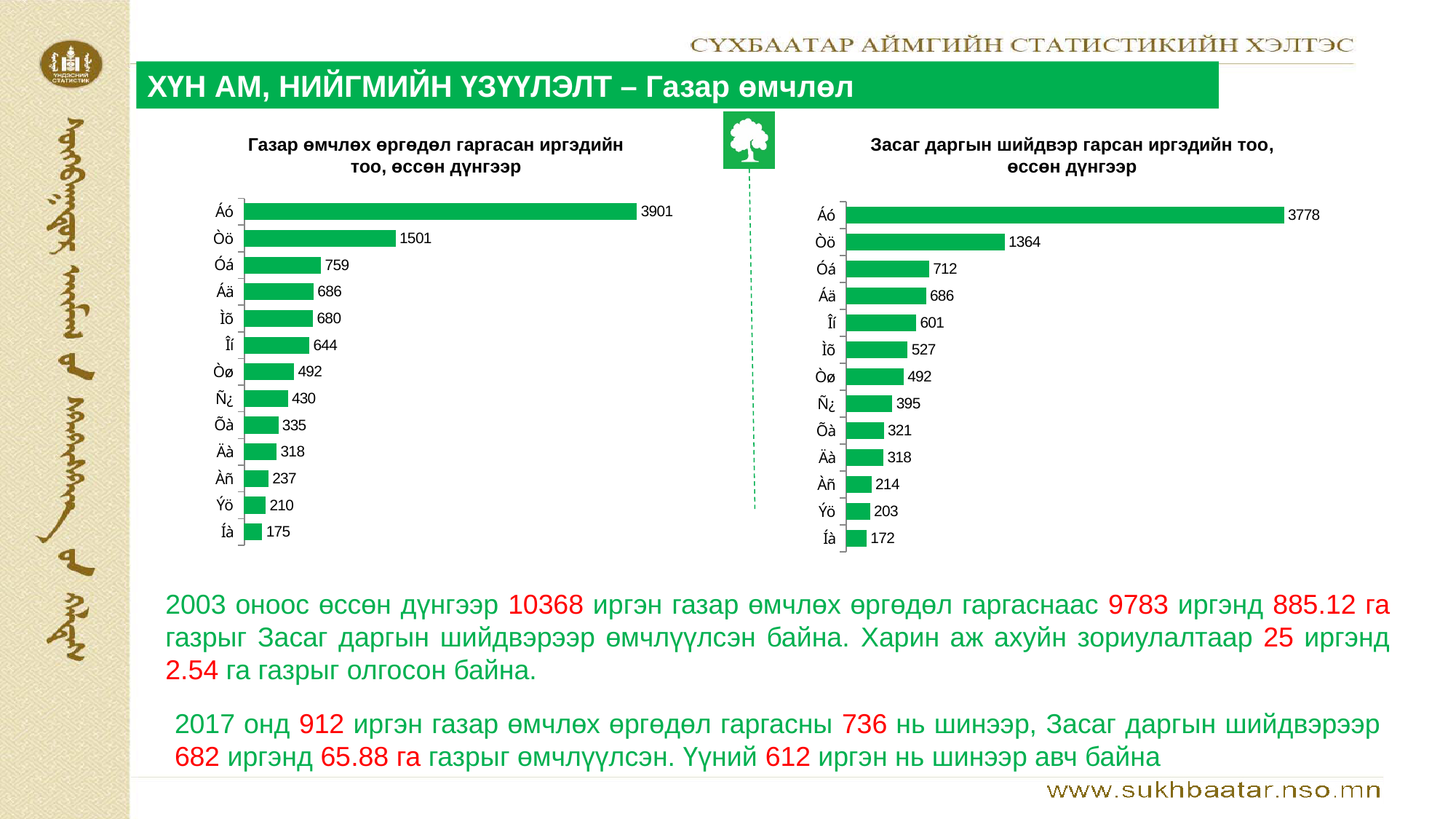
In the right chart, which category has the highest value? Áó In the right chart, what is the value for the bottom bar labelled Íà? 172 Which is larger: the value for Òö in the left chart or the value for Òö in the right chart? Left chart (1501) In the right chart, what is the difference between the values for Òö and Óá? 652 What type of chart is used on the left side of the slide? Bar chart What colour are the bars in both charts? Green In the left chart (Газар өмчлөх өргөдөл гаргасан иргэдийн тоо), what is the value of the top bar labelled Áó? 3901 In the left chart, what is the difference between the values for Áó and Òö? 2400 How many categories (bars) does the right chart show? 13 In the right chart (Засаг даргын шийдвэр гарсан иргэдийн тоо), what is the value of the top bar labelled Áó? 3778 In the left chart, which category has the lowest value? Íà How many categories (bars) does the left chart show? 13